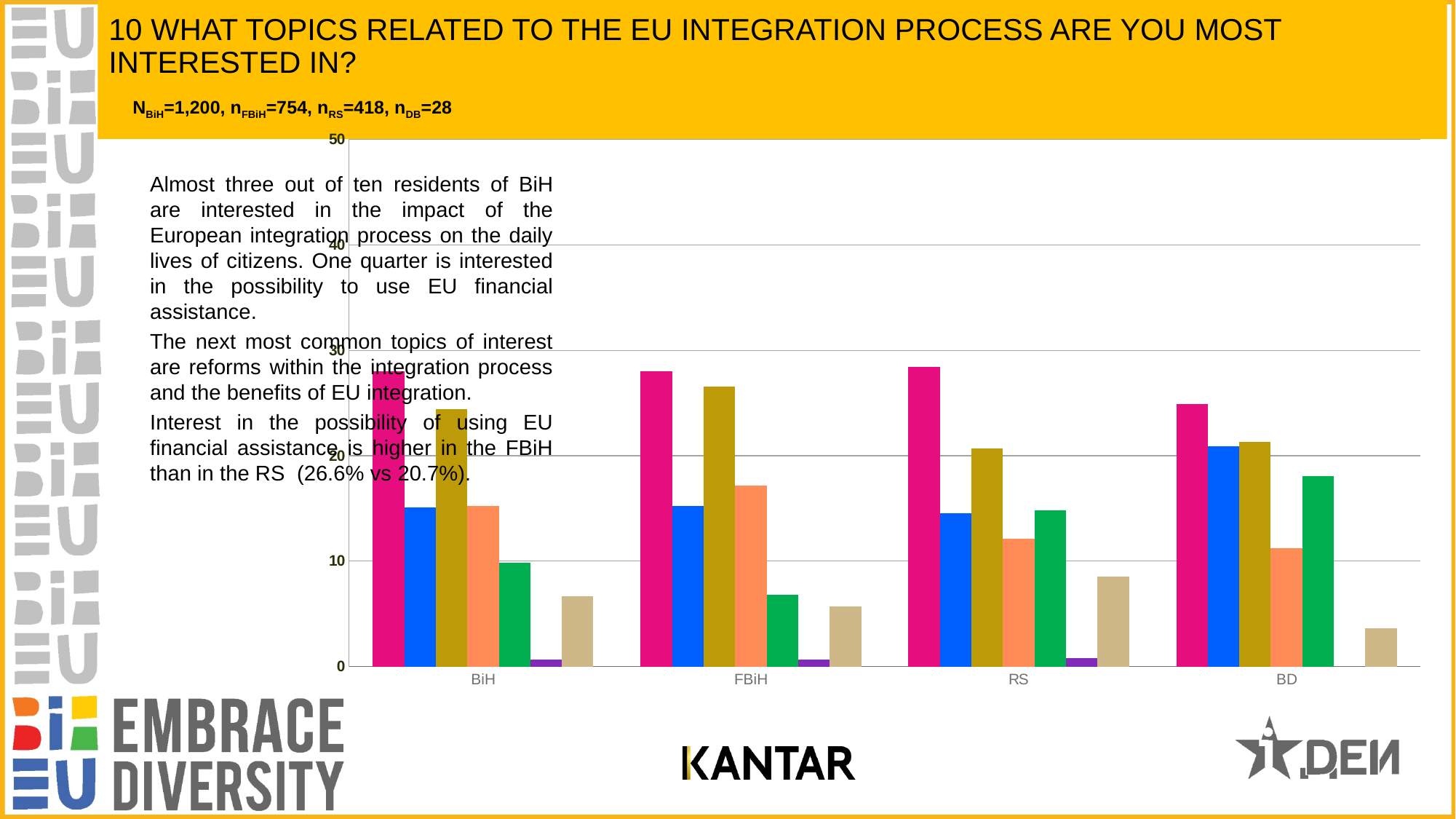
Which category has the shortest tan bar? BD What kind of chart is shown on the slide? bar chart Which category has the tallest green bar? BD What are the category labels on the x axis of the chart? BiH, FBiH, RS, BD In the BiH group, which coloured bar is the tallest? the magenta bar How many categories are shown on the x axis of the chart? 4 Is the value of the olive bar for FBiH greater or less than 20? greater Is the value of the magenta bar for BD greater or less than 20? greater What is the highest value shown on the y axis of the chart? 50 Is the value of the tan bar for BD greater or less than 10? less In the RS group, which is taller: the olive bar or the orange bar? the olive bar